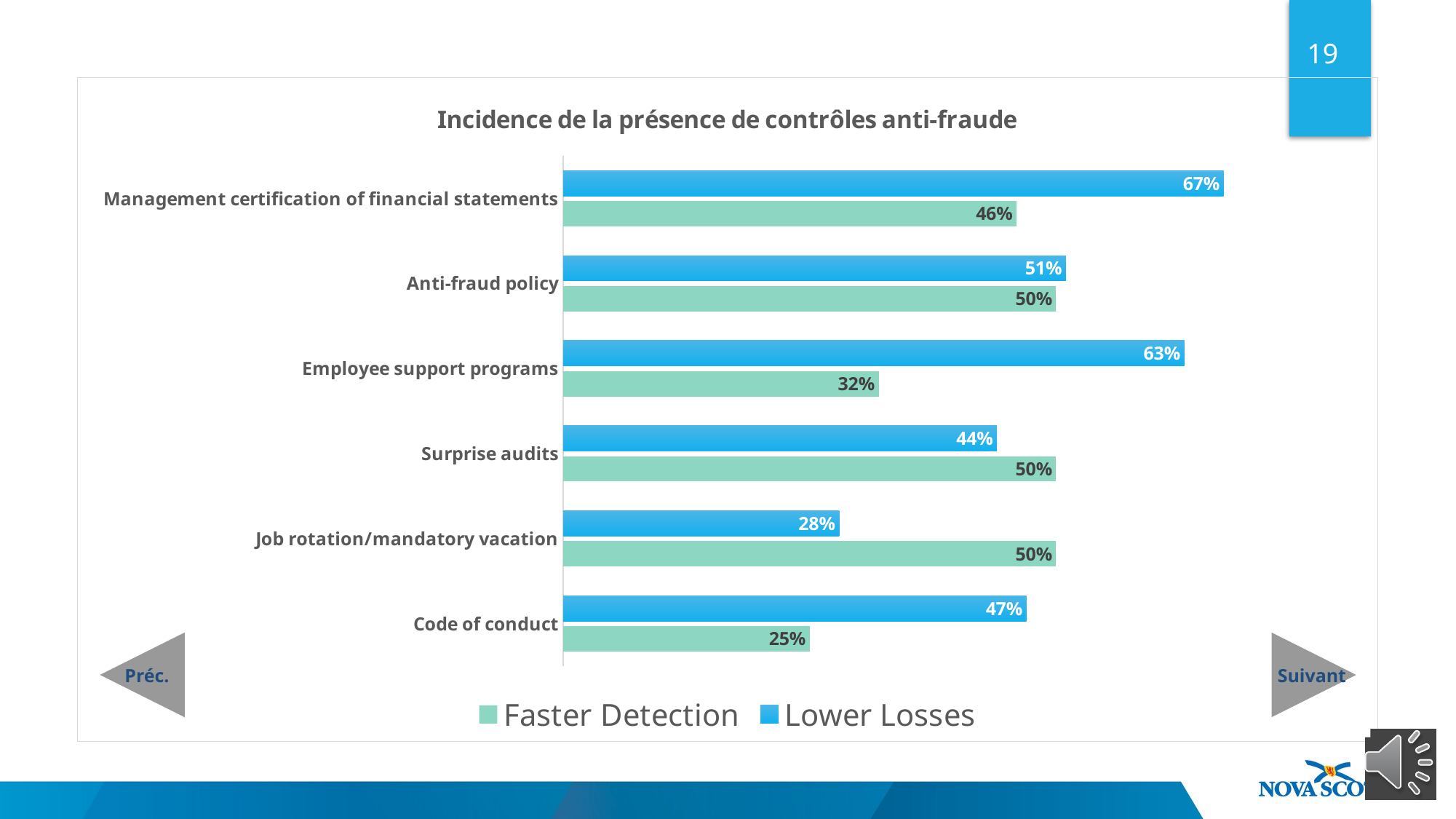
How many categories are shown on the chart? 6 What kind of chart is shown on the slide? Bar chart Which category has the highest Lower Losses value? Management certification of financial statements What is the Lower Losses value for Management certification of financial statements? 67% What is the Faster Detection value for Employee support programs? 32% For Job rotation/mandatory vacation, which is larger: Faster Detection or Lower Losses? Faster Detection What is the difference between the Lower Losses and Faster Detection values for Employee support programs? 31% Which category has the lowest Faster Detection value? Code of conduct What is the Faster Detection value for Code of conduct? 25% What is the title of the chart? Incidence de la présence de contrôles anti-fraude Which category has the lowest Lower Losses value? Job rotation/mandatory vacation How many series does the legend list? 2